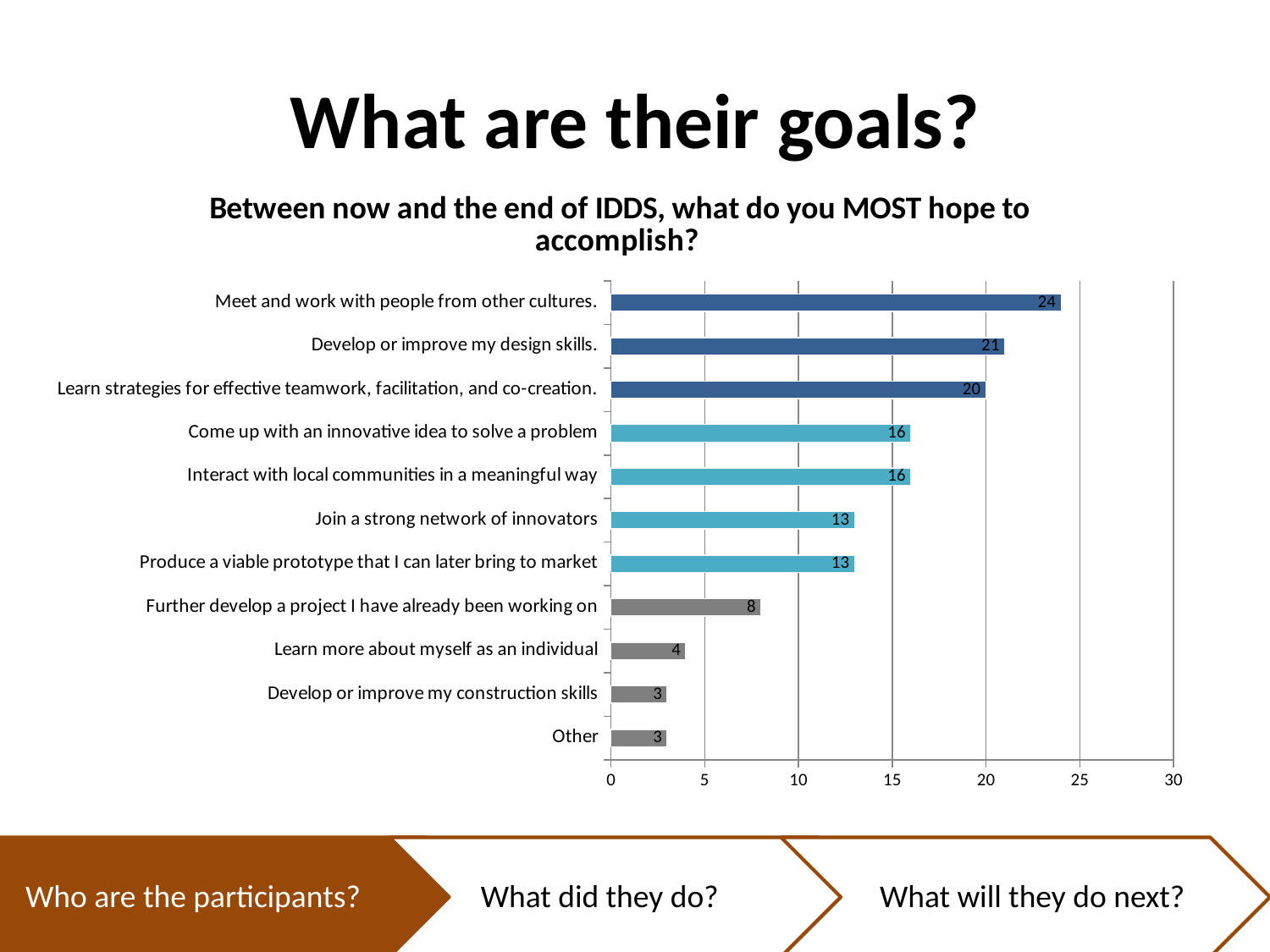
What is the value for "Meet and work with people from other cultures."? 24 What is the value for "Further develop a project I have already been working on"? 8 What is the difference between "Meet and work with people from other cultures." and "Other"? 21 Which category has the highest value? Meet and work with people from other cultures. Which is larger: "Come up with an innovative idea to solve a problem" or "Produce a viable prototype that I can later bring to market"? Come up with an innovative idea to solve a problem How many categories are shown in the chart? 11 What is the value for "Join a strong network of innovators"? 13 What kind of chart is shown on the slide? bar chart Is the value for "Learn strategies for effective teamwork, facilitation, and co-creation." greater or less than 15? greater What is the difference between "Develop or improve my design skills." and "Learn more about myself as an individual"? 17 What is the maximum value shown on the horizontal axis? 30 What is the chart's title? Between now and the end of IDDS, what do you MOST hope to accomplish?